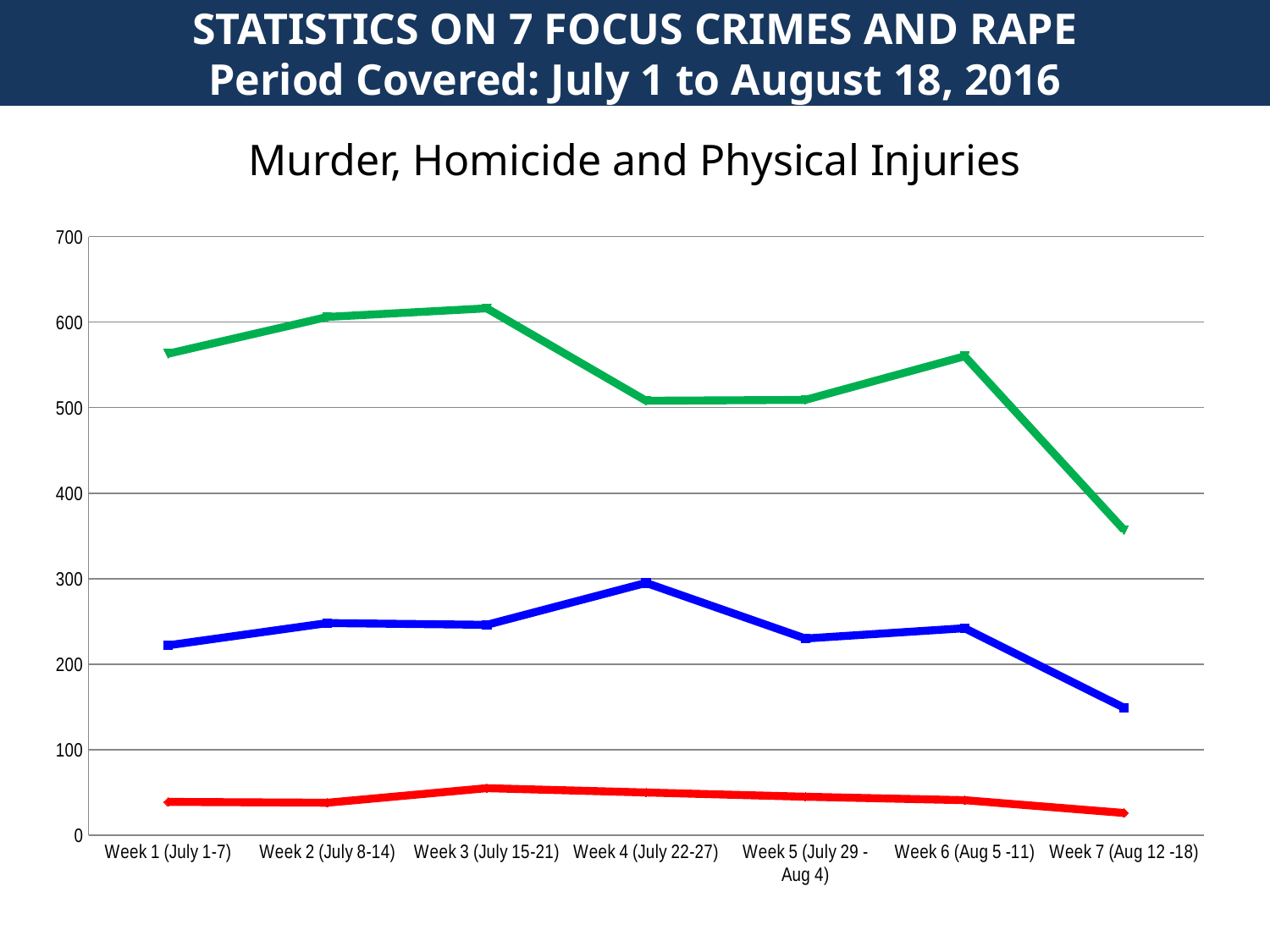
In which week does the green line reach its lowest value? Week 7 (Aug 12 -18) Is the value of the green line for Week 3 (July 15-21) greater or less than 600? greater How many weeks are shown along the x axis of the chart? 7 In which week does the blue line reach its highest value? Week 4 (July 22-27) At Week 1 (July 1-7), which line has the larger value, the green line or the blue line? green line What kind of chart is shown on the slide? line chart Is the value of the green line for Week 7 (Aug 12 -18) greater or less than 400? less How many lines are plotted on the chart? 3 Does the green line rise or fall from Week 6 (Aug 5 -11) to Week 7 (Aug 12 -18)? fall What is the title of the chart? Murder, Homicide and Physical Injuries Is the value of the red line for Week 3 (July 15-21) greater or less than 100? less